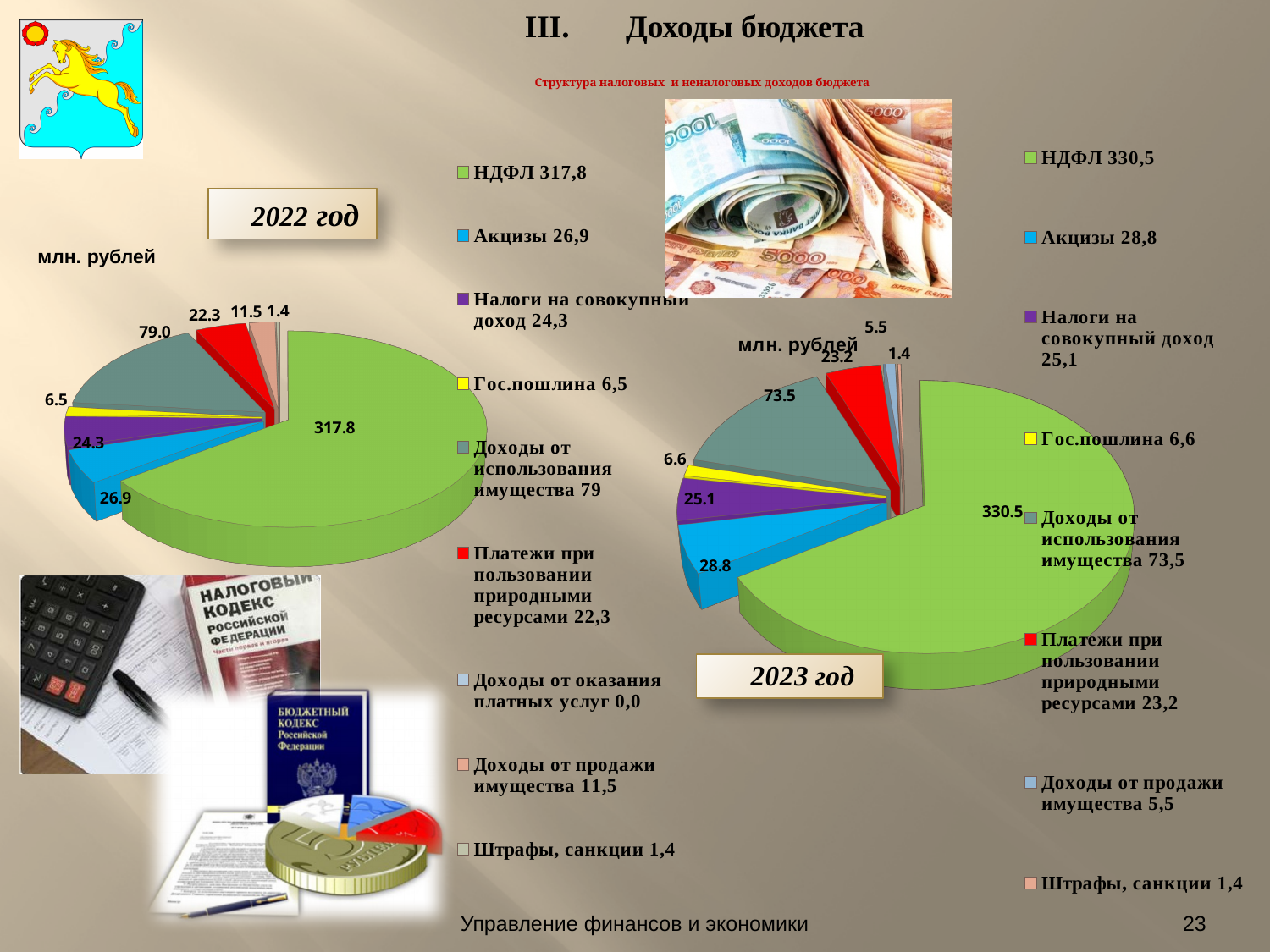
On the 2022 год pie chart, what is the difference between Доходы от использования имущества and Акцизы? 52.1 How many categories does the legend of the 2022 год pie chart list? 9 What type of chart is used for the 2023 год data? Pie chart On the 2023 год pie chart, which category has the largest value? НДФЛ On the 2022 год pie chart, which category has the smallest value? Доходы от оказания платных услуг By how much is НДФЛ on the 2023 год chart larger than НДФЛ on the 2022 год chart? 12.7 On the 2023 год pie chart, what is the value for Доходы от использования имущества? 73.5 On the 2023 год pie chart, which is larger: Акцизы or Налоги на совокупный доход? Акцизы On the 2023 год pie chart, what is the value for Доходы от продажи имущества? 5.5 On the 2022 год pie chart, what is the value for НДФЛ? 317.8 How many categories does the legend of the 2023 год pie chart list? 8 On the 2022 год pie chart, what is the value for Акцизы? 26.9